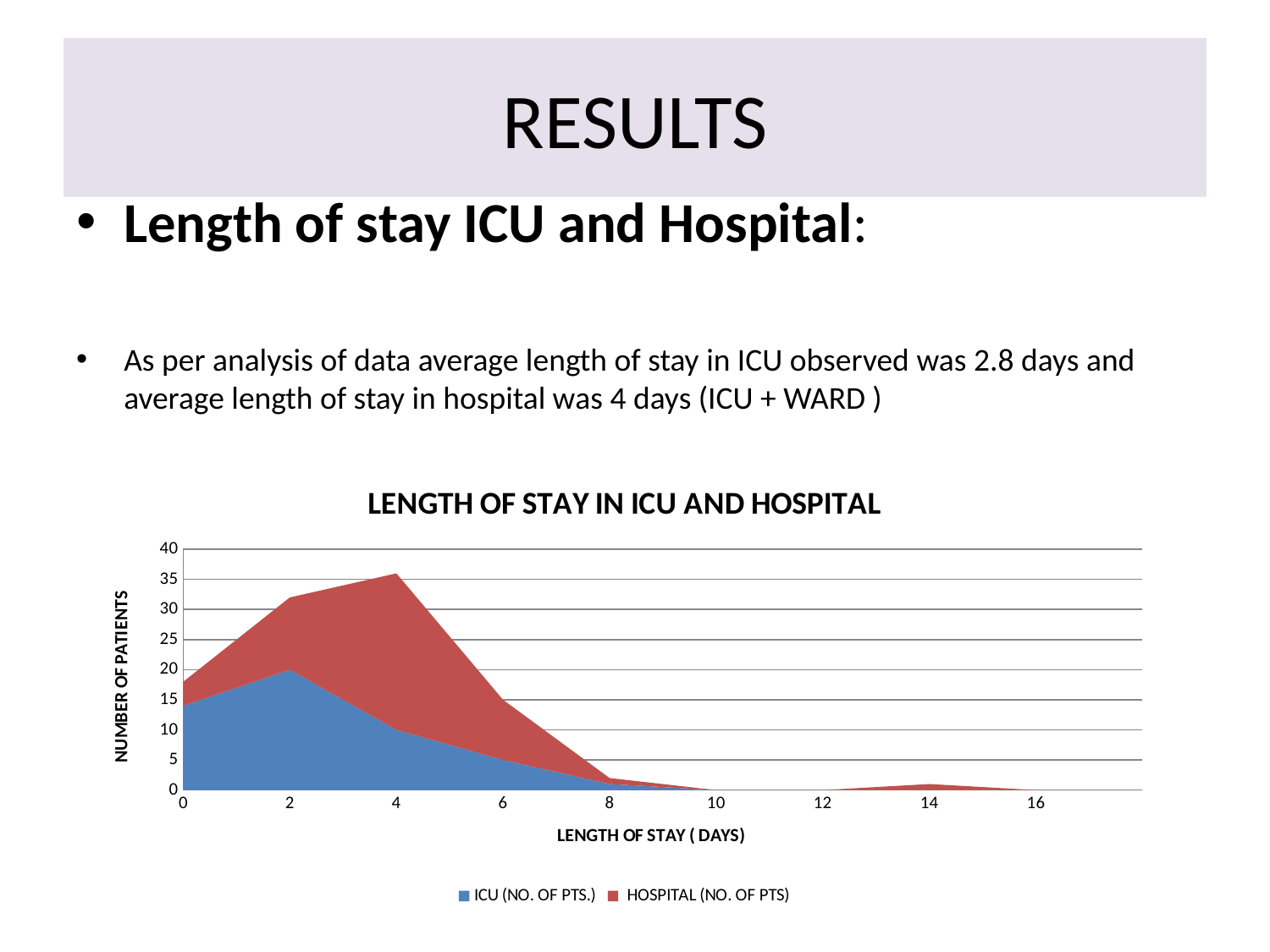
Is the ICU (NO. OF PTS.) value at 2 days greater or less than 15? greater At which length of stay does the ICU (NO. OF PTS.) series reach its highest value? 2 How many series does the chart legend list? 2 What is the title of the chart? LENGTH OF STAY IN ICU AND HOSPITAL Is the top of the HOSPITAL (NO. OF PTS) area at 8 days greater or less than 5? less Is the top of the HOSPITAL (NO. OF PTS) area at 4 days greater or less than 30? greater What is the label of the vertical axis of the chart? NUMBER OF PATIENTS Does the ICU (NO. OF PTS.) series rise or fall between 2 days and 8 days? fall Which is larger for the ICU (NO. OF PTS.) series: the value at 2 days or the value at 6 days? 2 days What kind of chart is shown on the slide? area chart